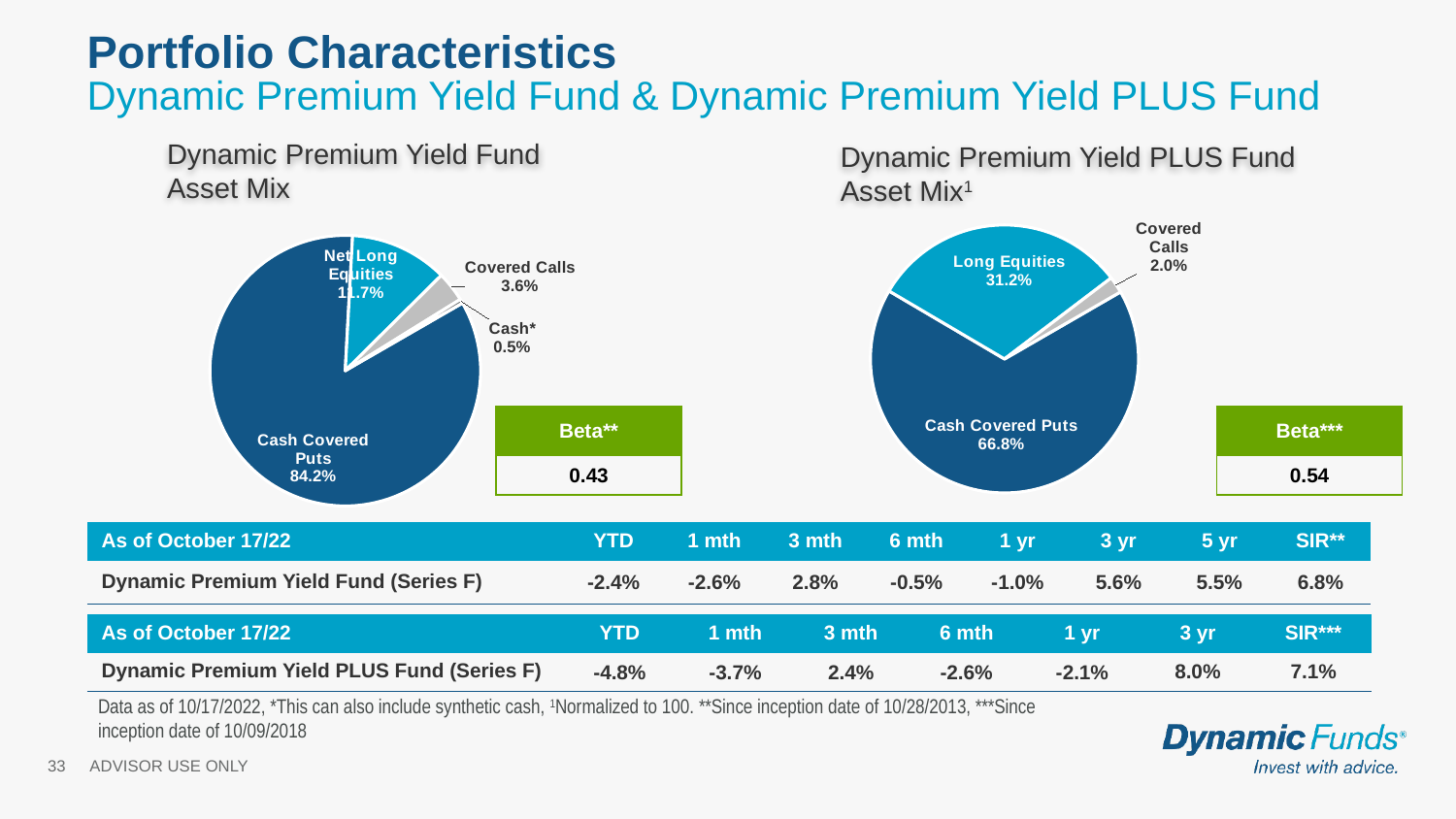
In the Dynamic Premium Yield Fund Asset Mix chart, what is the difference between the Cash Covered Puts share and the Net Long Equities share? 72.5% In the Dynamic Premium Yield Fund Asset Mix chart, what is the value for Net Long Equities? 11.7% In the Dynamic Premium Yield PLUS Fund Asset Mix chart, what is the difference between the Cash Covered Puts share and the Long Equities share? 35.6% How many categories are shown in the Dynamic Premium Yield Fund Asset Mix chart? 4 In the Dynamic Premium Yield Fund Asset Mix chart, what share of the portfolio is Cash Covered Puts? 84.2% What type of chart is the Dynamic Premium Yield PLUS Fund Asset Mix chart? Pie chart In the Dynamic Premium Yield PLUS Fund Asset Mix chart, what is the value for Covered Calls? 2.0% In the Dynamic Premium Yield PLUS Fund Asset Mix chart, which category has the largest share? Cash Covered Puts In the Dynamic Premium Yield Fund Asset Mix chart, which category has the smallest share? Cash* In the Dynamic Premium Yield Fund Asset Mix chart, what is the value for Cash*? 0.5% Which is larger: Covered Calls in the Dynamic Premium Yield Fund Asset Mix chart or Covered Calls in the Dynamic Premium Yield PLUS Fund Asset Mix chart? Dynamic Premium Yield Fund (3.6%) In the Dynamic Premium Yield PLUS Fund Asset Mix chart, what is the value for Long Equities? 31.2%